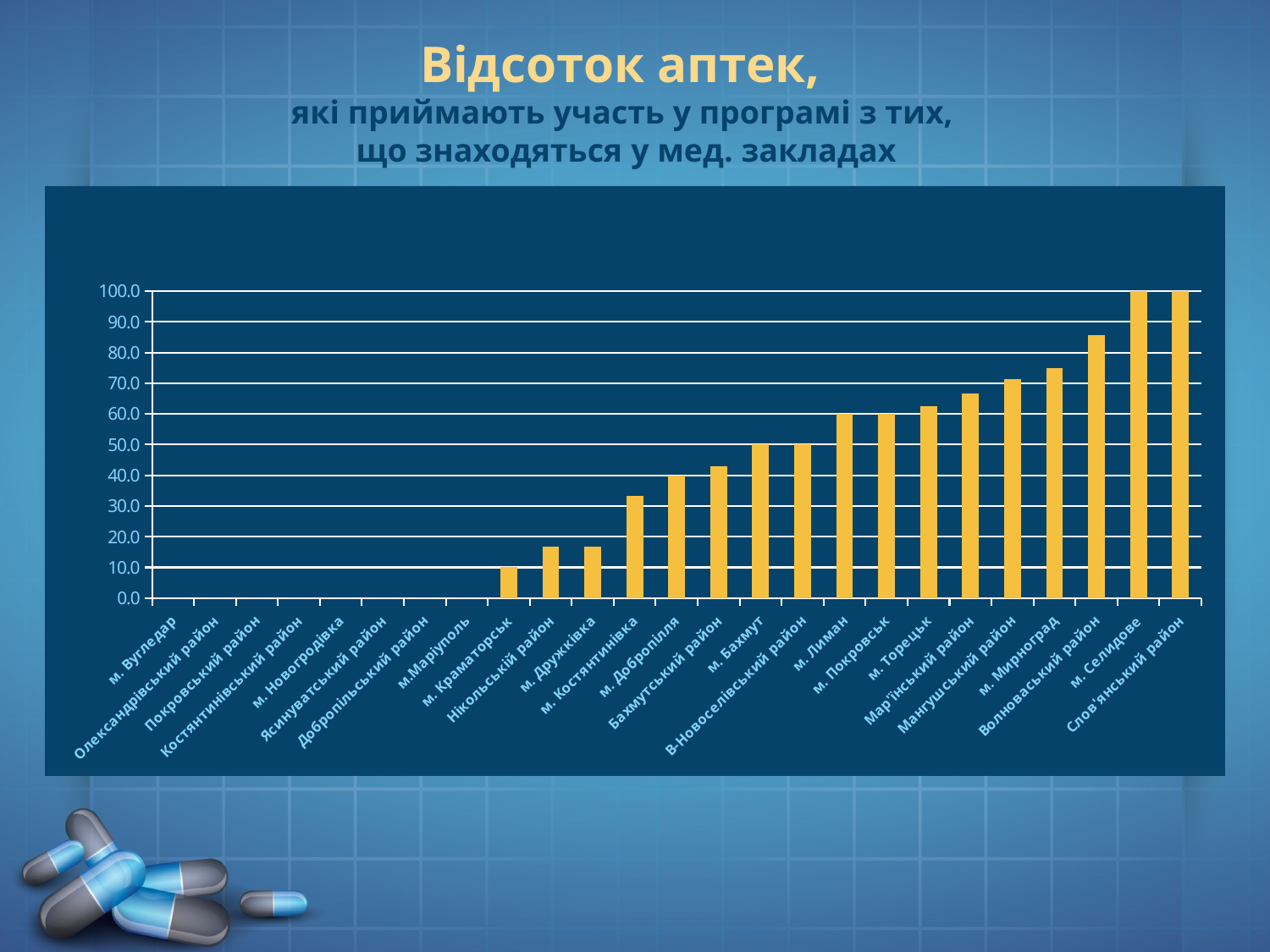
Is the value for Волноваський район greater or less than 80.0? greater What kind of chart is shown on the slide? bar chart Is the value for м. Мирноград greater or less than 70.0? greater Is the value for м. Костянтинівка greater or less than 30.0? greater How many categories are shown on the x axis of the chart? 25 What is the value for м. Селидове? 100.0 Which is larger, the value for м. Мирноград or the value for м. Лиман? м. Мирноград What colour are the bars in the chart? yellow What is the value for м. Бахмут? 50.0 Do the values generally rise or fall from left to right along the x axis? rise What is the value for м. Лиман? 60.0